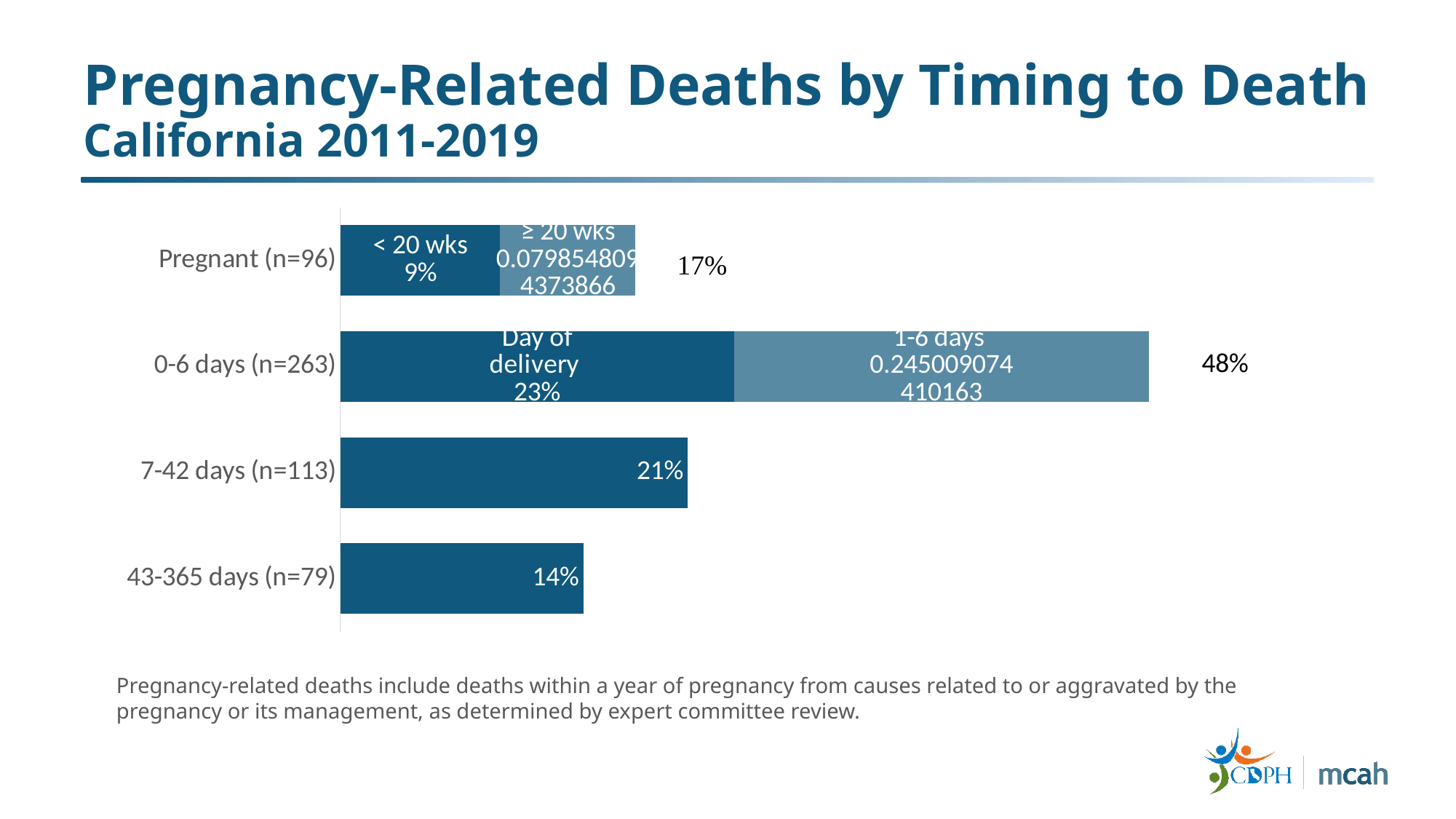
Which timing category has the highest percentage of pregnancy-related deaths? 0-6 days (n=263) What kind of chart is shown on the slide? Bar chart What percentage is shown for the < 20 wks segment of the Pregnant bar? 9% What percentage is shown for 7-42 days (n=113)? 21% What percentage is shown for the Day of delivery segment of the 0-6 days bar? 23% How many timing categories are shown on the chart? 4 Which is larger, the percentage for 7-42 days or the percentage for Pregnant? 7-42 days What is the total percentage shown for the Pregnant (n=96) bar? 17% What is the total percentage shown for the 0-6 days (n=263) bar? 48% What percentage is shown for 43-365 days (n=79)? 14% What is the difference in percentage points between the 7-42 days bar and the 43-365 days bar? 7 Which timing category has the lowest percentage of pregnancy-related deaths? 43-365 days (n=79)